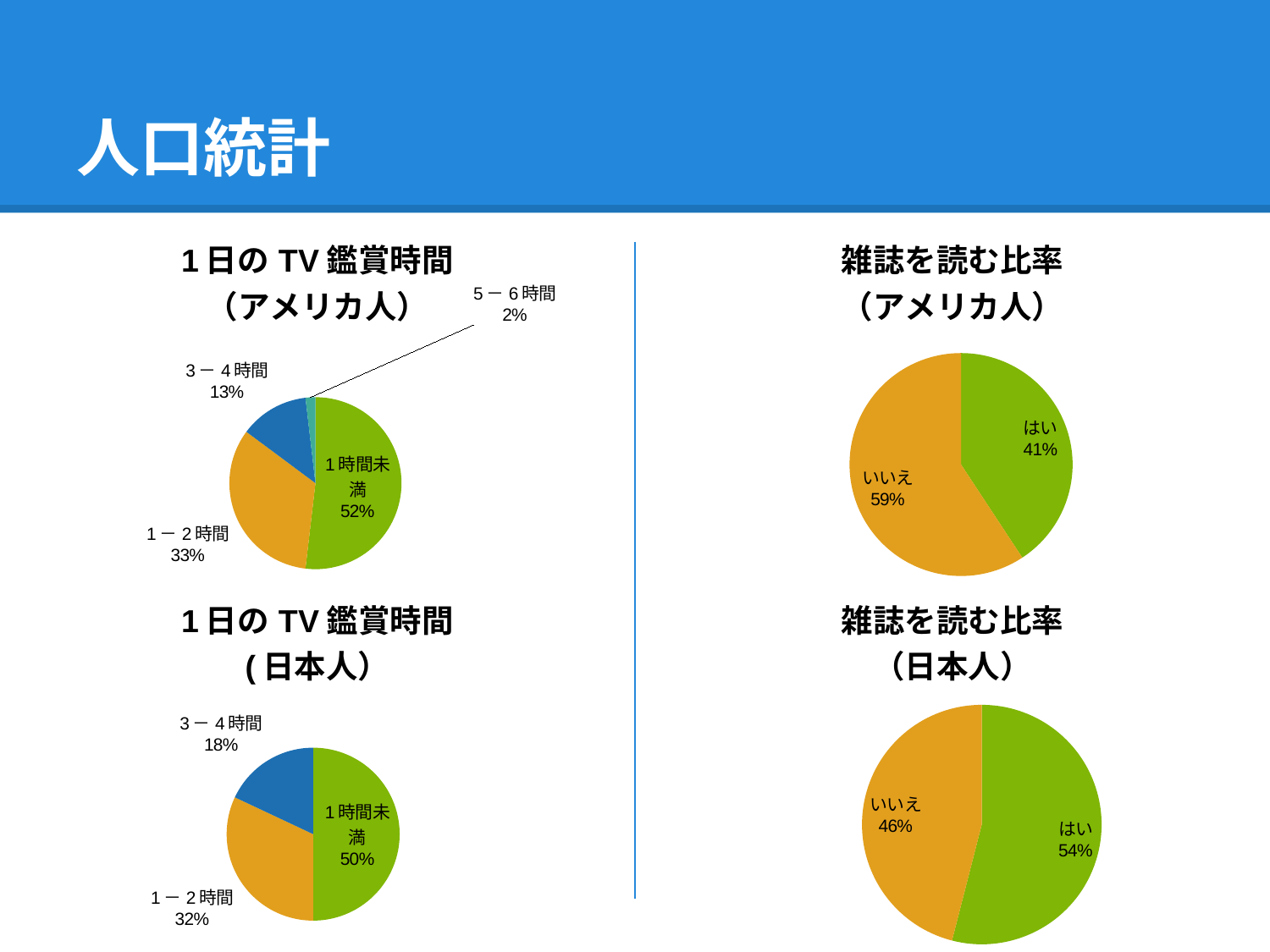
In the chart titled 「1日のTV鑑賞時間(日本人)」, which category has the largest slice? 1時間未満 In the chart titled 「1日のTV鑑賞時間(日本人)」, what is the difference between the 1時間未満 share and the 1－2時間 share? 18% In the chart titled 「1日のTV鑑賞時間（アメリカ人）」, which category has the smallest slice? 5－6時間 In the chart titled 「雑誌を読む比率（アメリカ人）」, which is larger, はい or いいえ? いいえ In the chart titled 「1日のTV鑑賞時間（アメリカ人）」, how many slices does the pie have? 4 What kind of chart is used for 「雑誌を読む比率（日本人）」? Pie chart In the chart titled 「1日のTV鑑賞時間（アメリカ人）」, what share is labelled for 5－6時間? 2% In the chart titled 「雑誌を読む比率（日本人）」, what is the difference between the はい share and the いいえ share? 8% In the chart titled 「1日のTV鑑賞時間(日本人)」, what share is labelled for 3－4時間? 18% In the chart titled 「雑誌を読む比率（日本人）」, what share is labelled for いいえ? 46% In the chart titled 「1日のTV鑑賞時間（アメリカ人）」, what share is labelled for 1時間未満? 52% In the chart titled 「雑誌を読む比率（アメリカ人）」, what share is labelled for はい? 41%